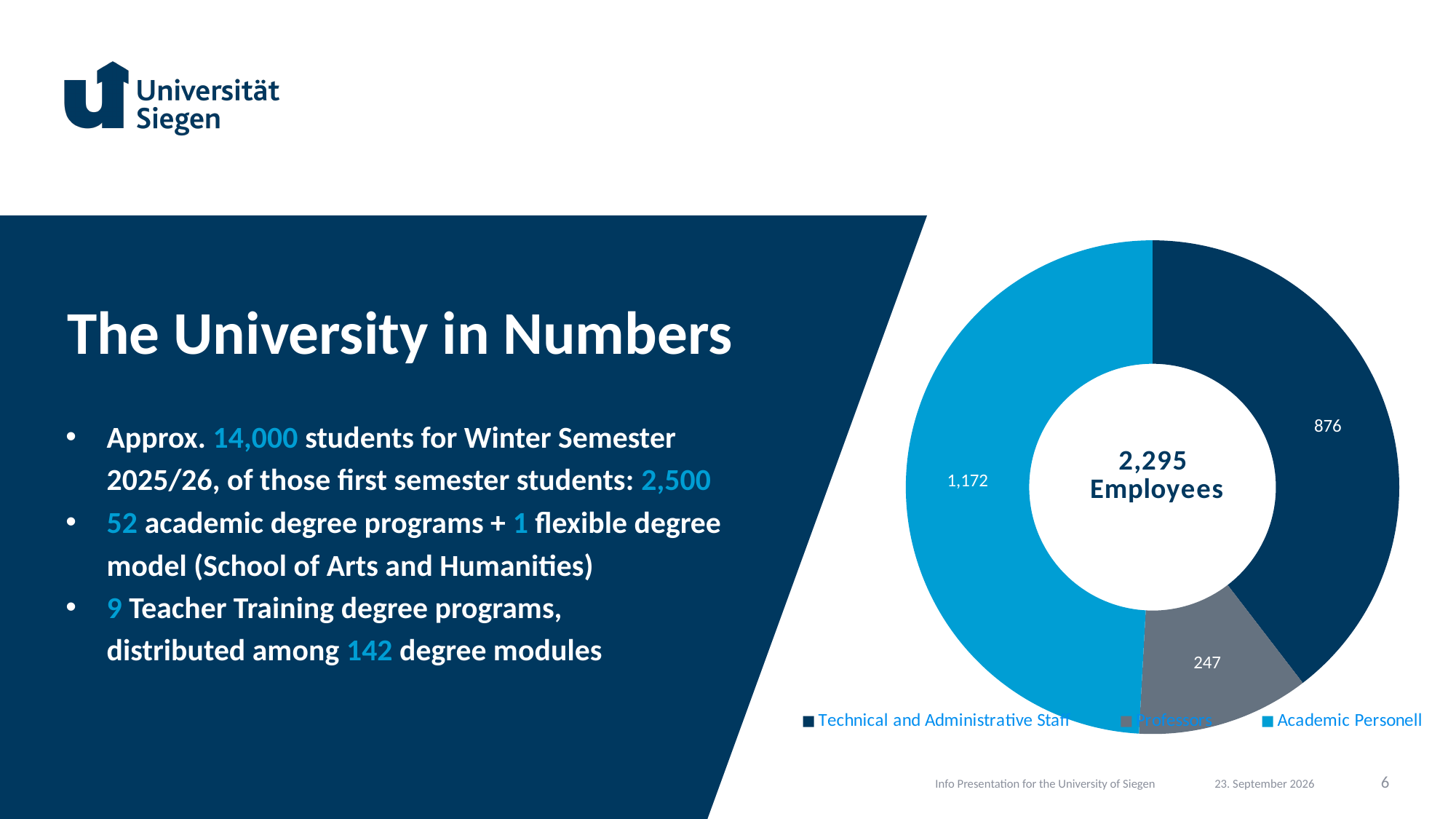
What type of chart is shown on the slide? Doughnut chart Which colour represents Professors in the chart? Grey Which group is larger: Technical and Administrative Staff or Professors? Technical and Administrative Staff What total number of employees is shown in the centre of the chart? 2,295 Employees How many employee groups does the chart divide the employees into? 3 How many employees are Academic Personell according to the chart? 1,172 How many employees are Technical and Administrative Staff according to the chart? 876 What is the difference between the number of Academic Personell and the number of Technical and Administrative Staff? 296 Which employee group is the largest in the chart? Academic Personell What is the difference between the number of Technical and Administrative Staff and the number of Professors? 629 How many Professors does the chart show? 247 Which employee group is the smallest in the chart? Professors